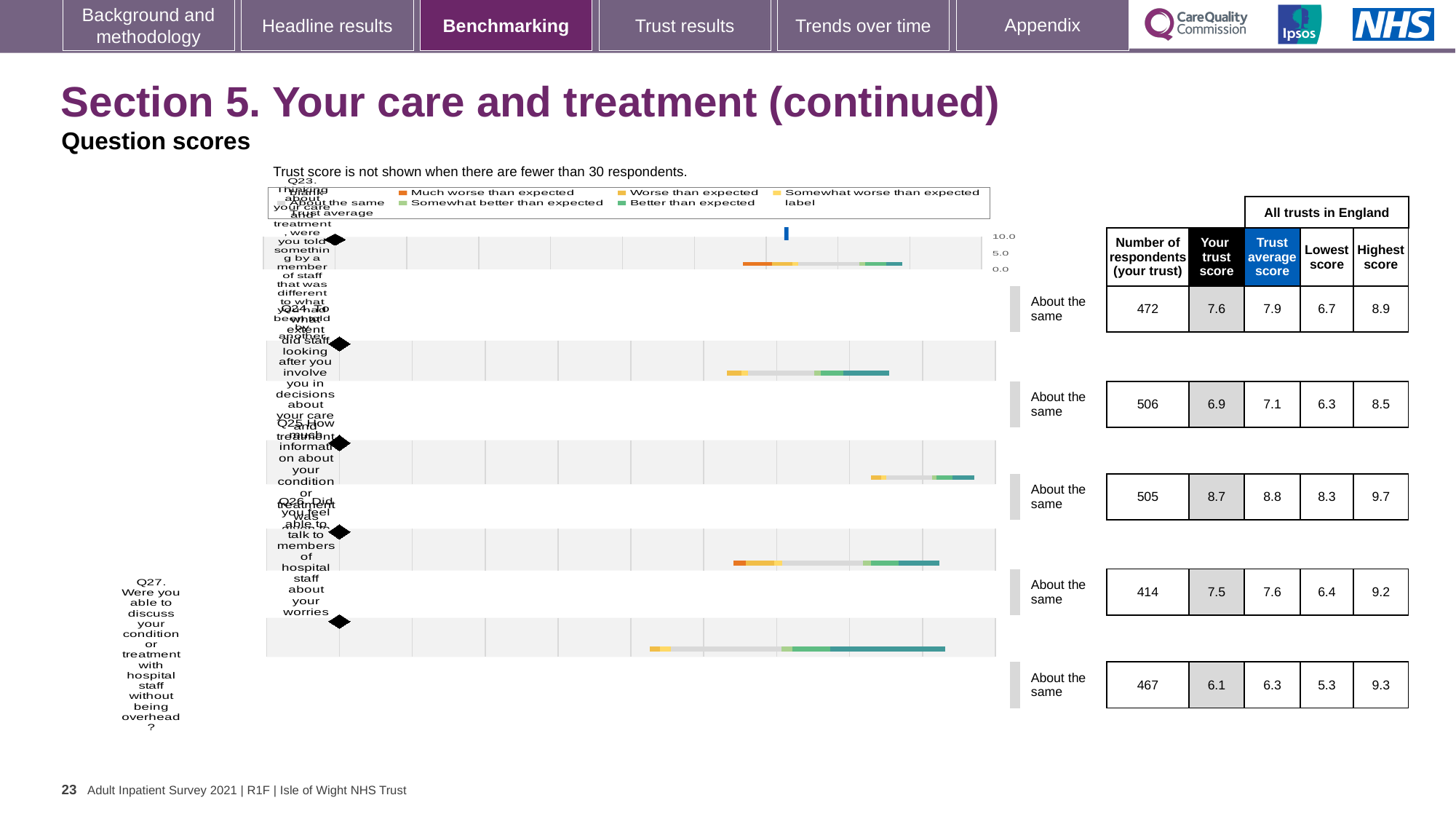
Which question has the lowest 'Your trust score'? Q27 How many respondents from your trust answered Q23? 472 What is the highest score across all trusts in England for Q25? 9.7 What kind of chart is shown on the slide? Bar chart How many questions are shown on the chart? 5 What is the lowest score across all trusts in England for Q26? 6.4 What is your trust score for Q27? 6.1 What is the difference between the trust average score and your trust score for Q27? 0.2 What is the trust average score for Q24? 7.1 What is your trust score for Q23? 7.6 Which question has the highest 'Your trust score'? Q25 Which has the larger 'Your trust score', Q23 or Q24? Q23